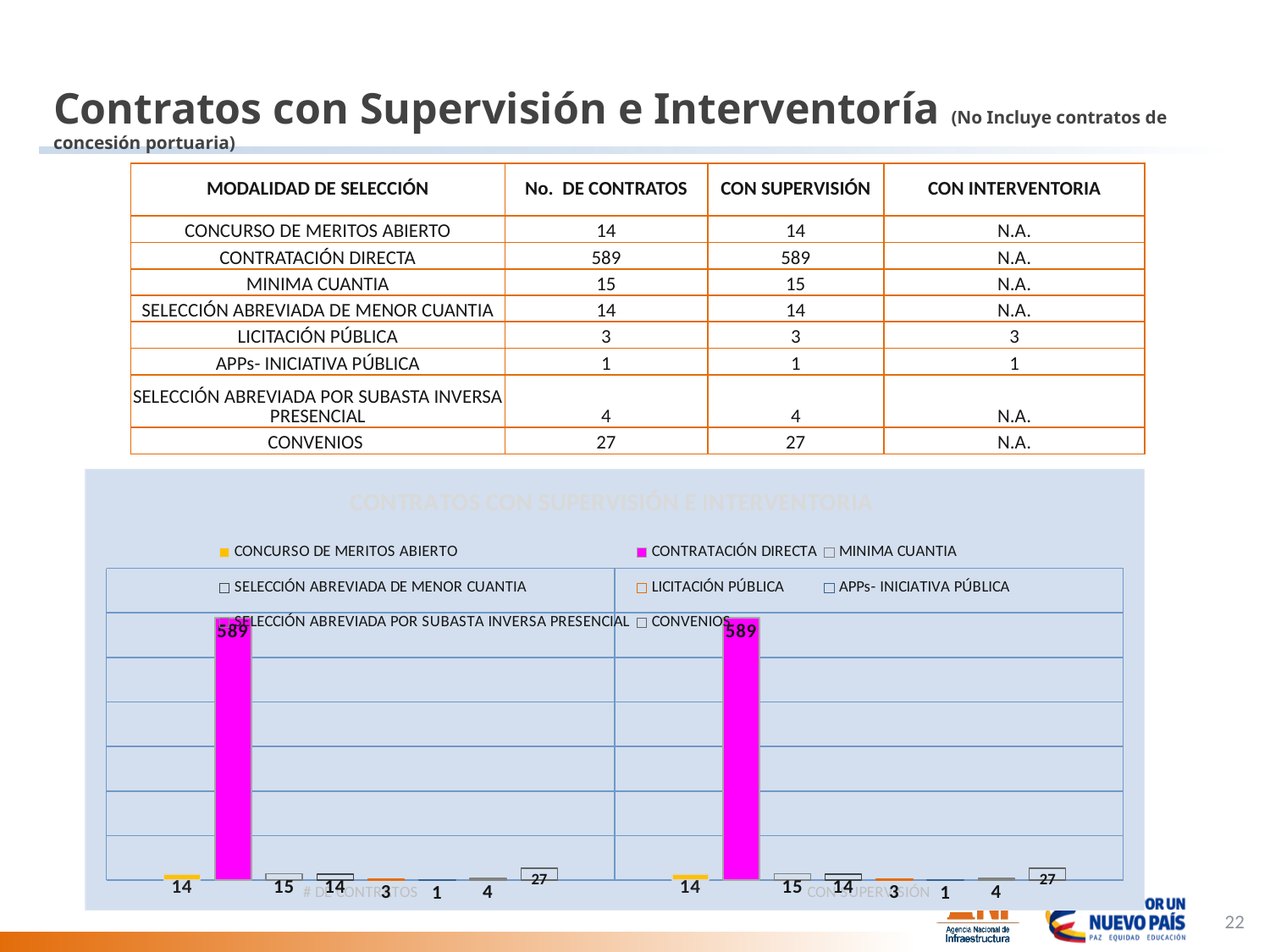
What colour is the bar for CONTRATACIÓN DIRECTA in the chart? magenta How many series does the chart legend list? 8 In the chart, which is larger in the CON SUPERVISIÓN group: CONVENIOS or MINIMA CUANTIA? CONVENIOS In the chart, what is the difference between CONTRATACIÓN DIRECTA and CONVENIOS in the # DE CONTRATOS group? 562 In the chart, what is the value of CONTRATACIÓN DIRECTA for # DE CONTRATOS? 589 What kind of chart is shown at the bottom of the slide? bar chart How many category groups are shown on the x axis of the chart? 2 Which series has the lowest value in the CON SUPERVISIÓN group of the chart? APPs- INICIATIVA PÚBLICA Which series has the highest value in the # DE CONTRATOS group of the chart? CONTRATACIÓN DIRECTA In the chart, what is the value of MINIMA CUANTIA for # DE CONTRATOS? 15 In the chart, what is the value of CONVENIOS for CON SUPERVISIÓN? 27 In the chart, what is the value of APPs- INICIATIVA PÚBLICA for CON SUPERVISIÓN? 1